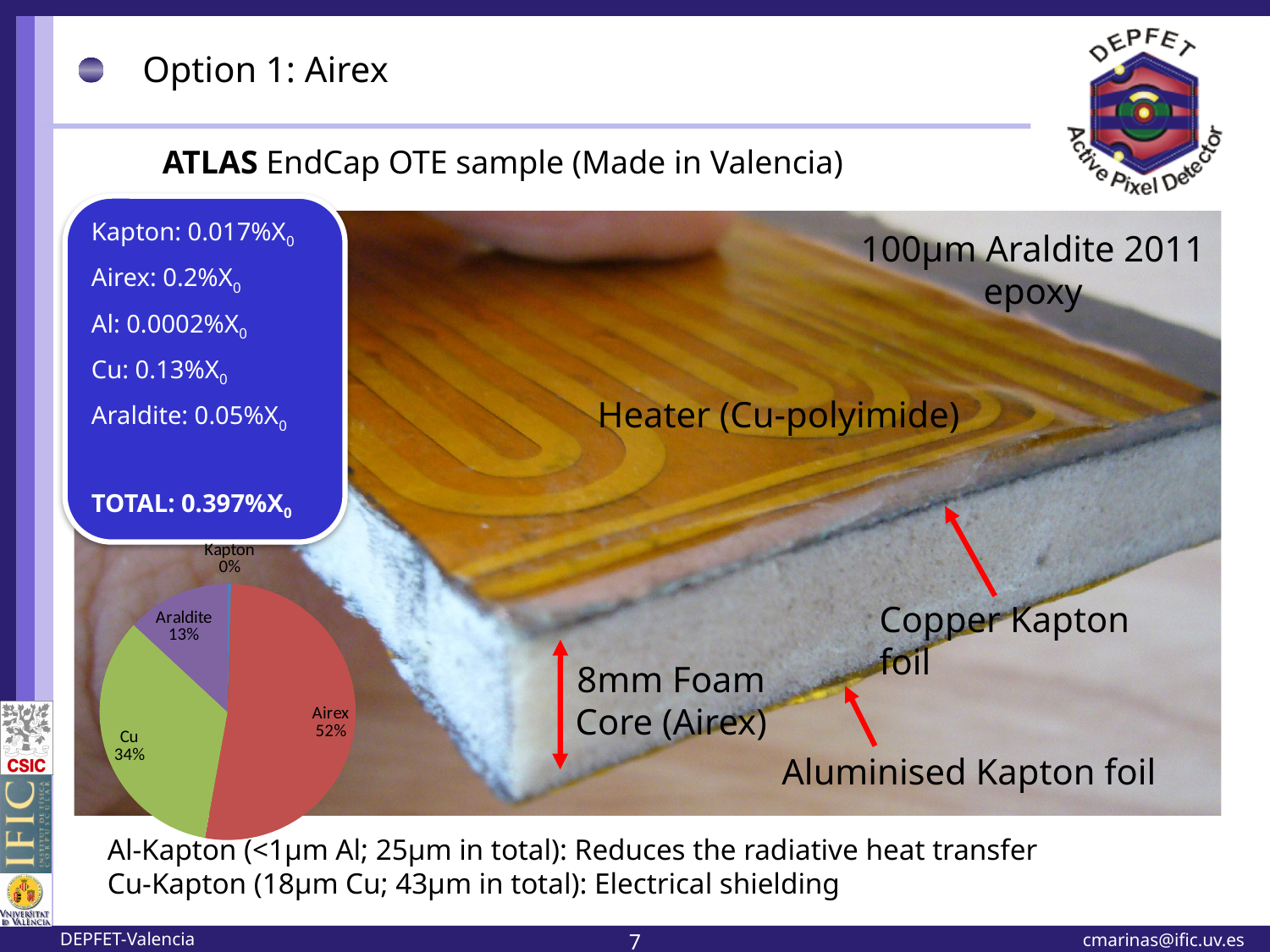
What share of the pie chart does Airex have? 52% Which slice is larger in the pie chart, Cu or Araldite? Cu Which labeled material has the smallest slice in the pie chart? Kapton What share of the pie chart does Cu have? 34% What type of chart is shown on the slide? pie chart Which material has the largest slice in the pie chart? Airex What colour is the Airex slice in the pie chart? red What is the difference in percentage points between the Airex and Cu slices in the pie chart? 18 What share of the pie chart does Kapton have? 0% Does the Airex slice account for more or less than half of the pie chart? more What is the difference in percentage points between the Cu and Araldite slices in the pie chart? 21 What share of the pie chart does Araldite have? 13%